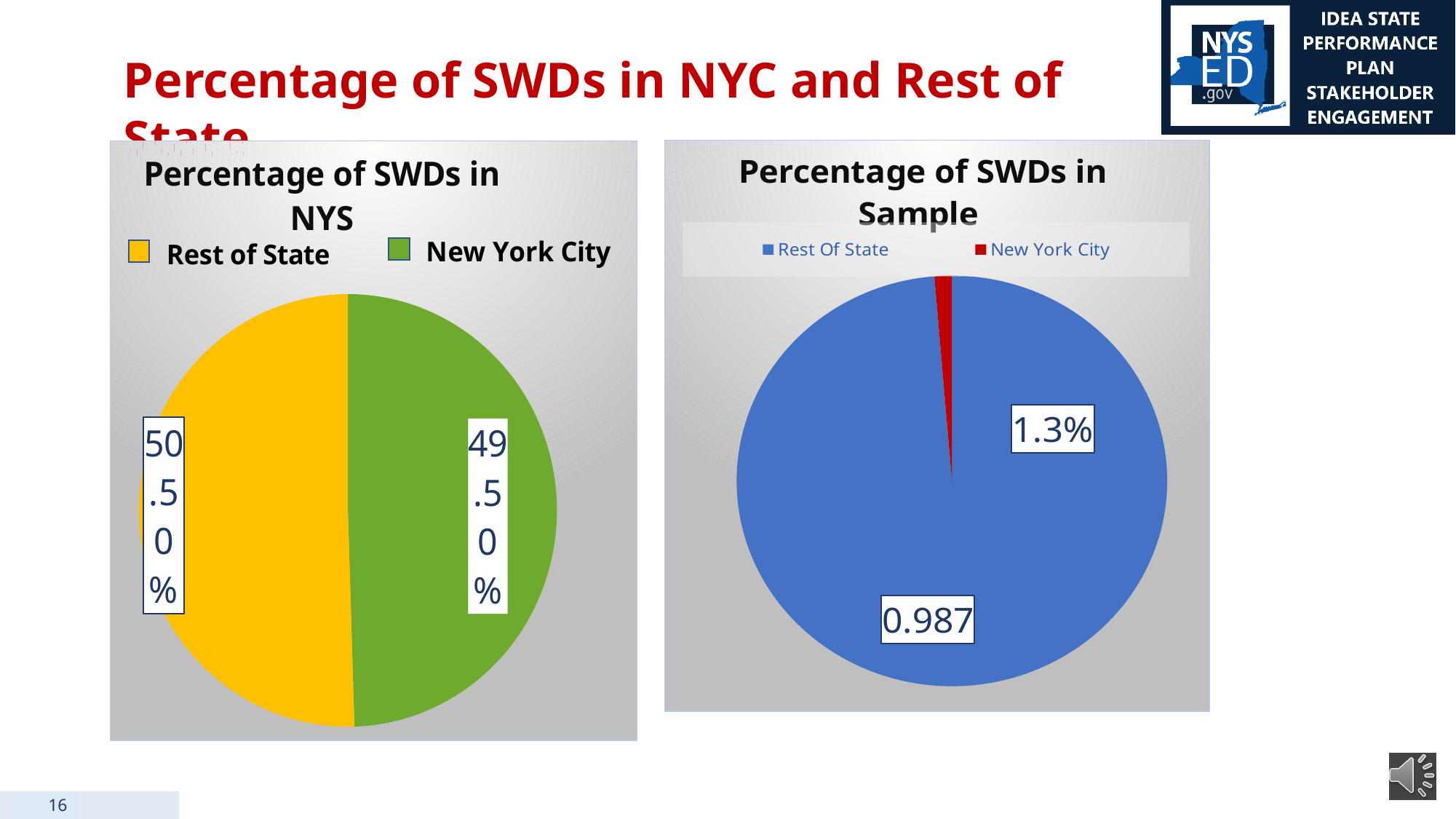
In the 'Percentage of SWDs in Sample' chart, is the Rest Of State slice larger or smaller than the New York City slice? larger What kind of chart is the 'Percentage of SWDs in Sample' chart? pie chart In the 'Percentage of SWDs in Sample' chart, which category has the smallest slice? New York City In the 'Percentage of SWDs in NYS' chart, what is the difference between the Rest of State and New York City values? 1.00% In the 'Percentage of SWDs in NYS' chart, what colour is the Rest of State slice? yellow In the 'Percentage of SWDs in Sample' chart, what is the value shown for Rest Of State? 0.987 In the 'Percentage of SWDs in NYS' chart, what is the value for New York City? 49.50% How many entries does the legend of the 'Percentage of SWDs in Sample' chart list? 2 In the 'Percentage of SWDs in Sample' chart, what is the value shown for New York City? 1.3% How many slices does the 'Percentage of SWDs in NYS' chart have? 2 In the 'Percentage of SWDs in NYS' chart, what is the value for Rest of State? 50.50% In the 'Percentage of SWDs in NYS' chart, which category has the larger share? Rest of State